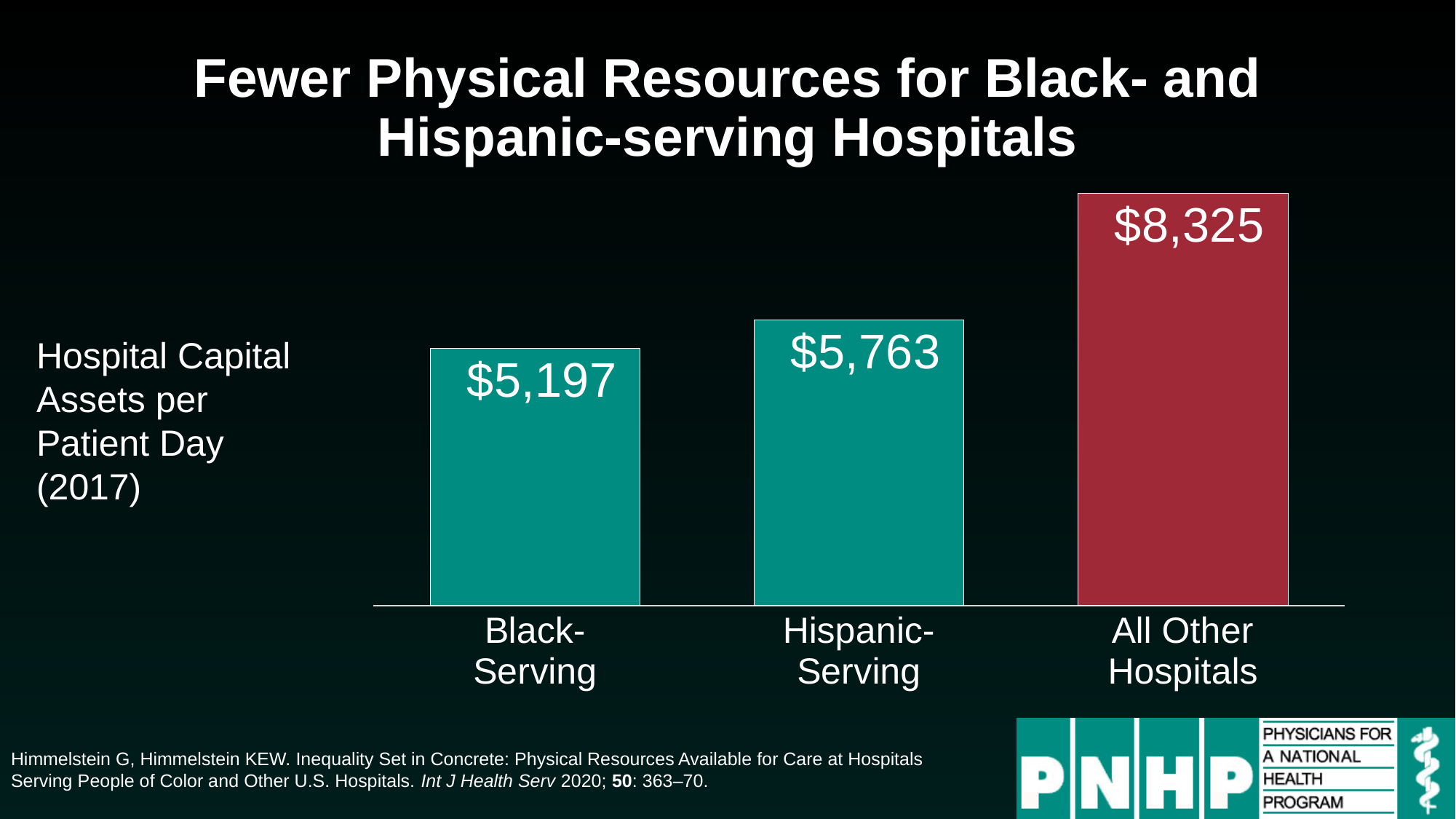
What is the difference between All Other Hospitals and Black-Serving hospitals? $3,128 What kind of chart is shown on the slide? Bar chart What is the difference between Hispanic-Serving and Black-Serving hospitals? $566 How many categories are shown in the chart? 3 What is the difference between All Other Hospitals and Hispanic-Serving hospitals? $2,562 What is the value for Black-Serving hospitals? $5,197 Which category has the highest hospital capital assets per patient day? All Other Hospitals Which bar is coloured red rather than teal? All Other Hospitals What is the value for Hispanic-Serving hospitals? $5,763 What is the value for All Other Hospitals? $8,325 Which is larger, the value for Hispanic-Serving or Black-Serving hospitals? Hispanic-Serving Which category has the lowest hospital capital assets per patient day? Black-Serving